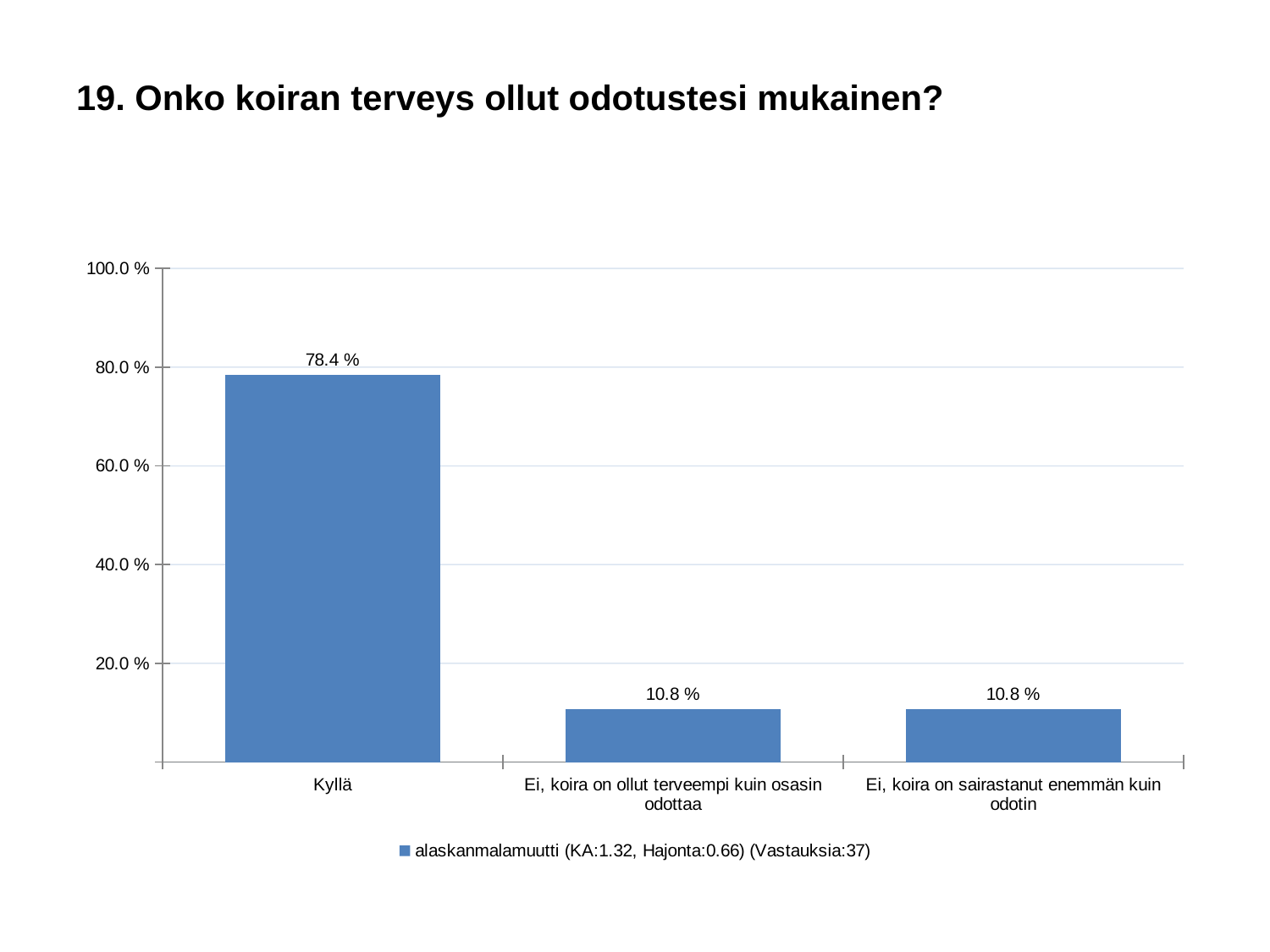
What kind of chart is shown on the slide? bar chart Is the value for "Kyllä" greater or less than 60.0 %? greater How many series does the legend list? 1 Which is larger: the value for "Kyllä" or the value for "Ei, koira on ollut terveempi kuin osasin odottaa"? Kyllä What is the value for "Ei, koira on ollut terveempi kuin osasin odottaa"? 10.8 % How many categories are shown on the x axis? 3 What is the value for "Kyllä"? 78.4 % Which category has the highest value? Kyllä Is the value for "Ei, koira on sairastanut enemmän kuin odotin" greater or less than 20.0 %? less How many responses (Vastauksia) does the legend entry report? 37 What is the difference between the value for "Kyllä" and the value for "Ei, koira on sairastanut enemmän kuin odotin"? 67.6 % What is the value for "Ei, koira on sairastanut enemmän kuin odotin"? 10.8 %